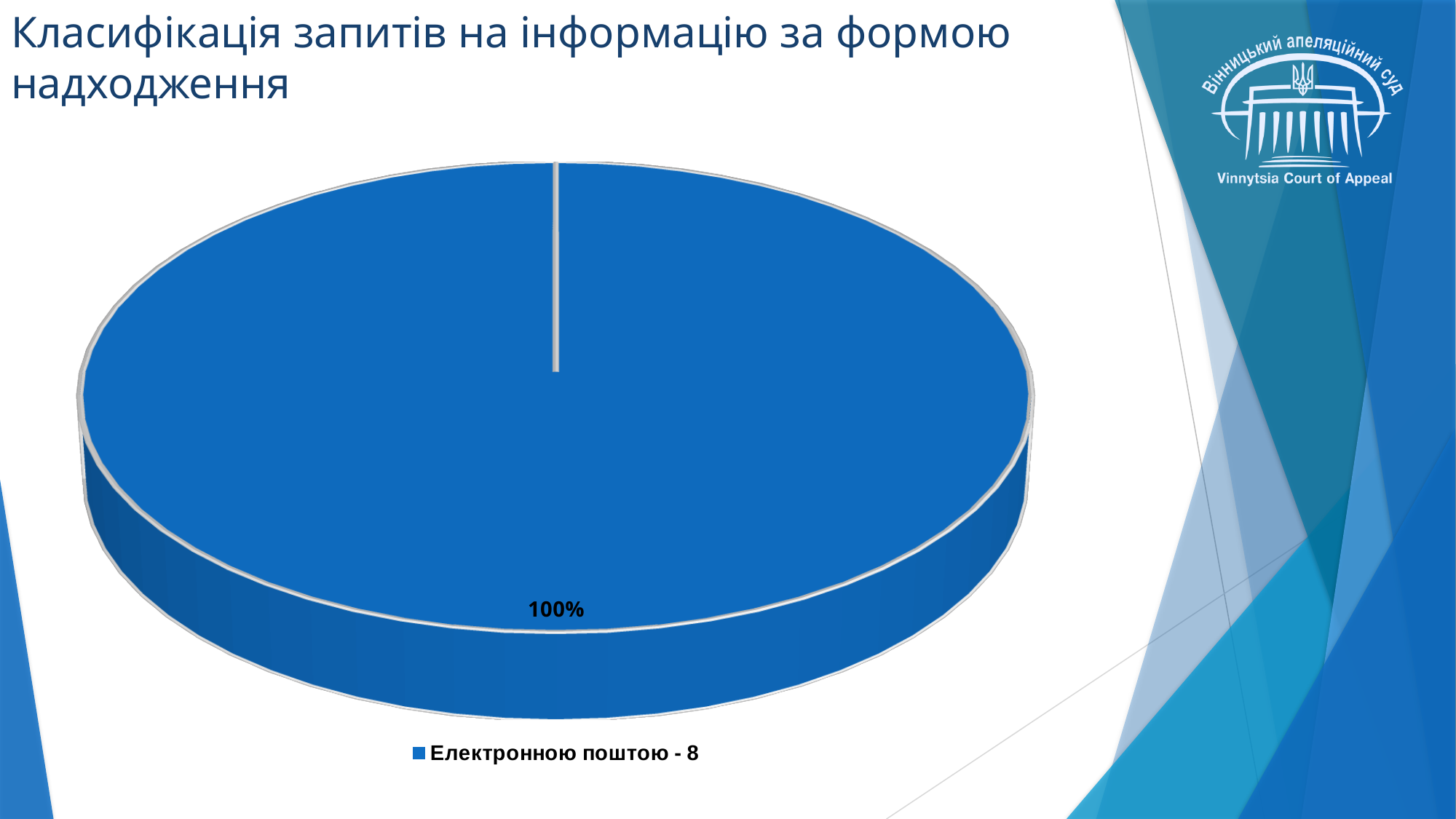
What is the title of the slide containing the pie chart? Класифікація запитів на інформацію за формою надходження What is the legend entry for the pie chart? Електронною поштою - 8 What share of the pie does the slice "Електронною поштою - 8" represent? 100% What percentage label is printed on the pie chart? 100% What kind of chart is shown on the slide? pie chart How many slices does the pie chart have? 1 How many requests were received by e-mail according to the legend? 8 How many entries does the legend list? 1